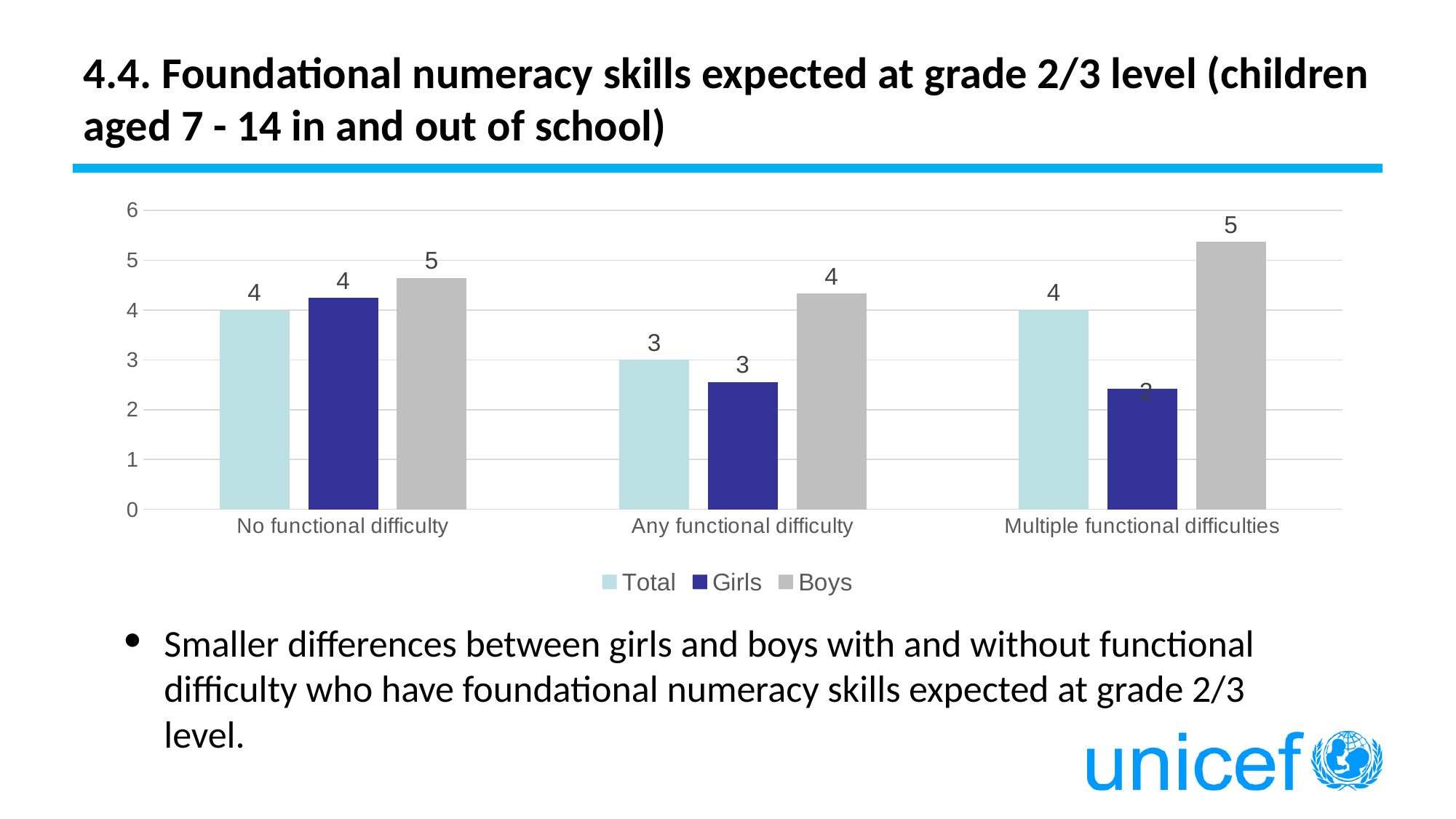
Which series has the lowest value in the Multiple functional difficulties category? Girls Using the data labels, what is the difference between Boys and Girls in the Multiple functional difficulties category? 3 What is the value for Boys in the Multiple functional difficulties category? 5 What is the value for Girls in the Any functional difficulty category? 3 Do the Girls values rise or fall from No functional difficulty to Multiple functional difficulties? fall Which is larger in the Any functional difficulty category, the Boys value or the Girls value? Boys How many series does the legend list? 3 Which series has the highest value in the Multiple functional difficulties category? Boys How many categories are shown on the x axis? 3 What is the Total value for the No functional difficulty category? 4